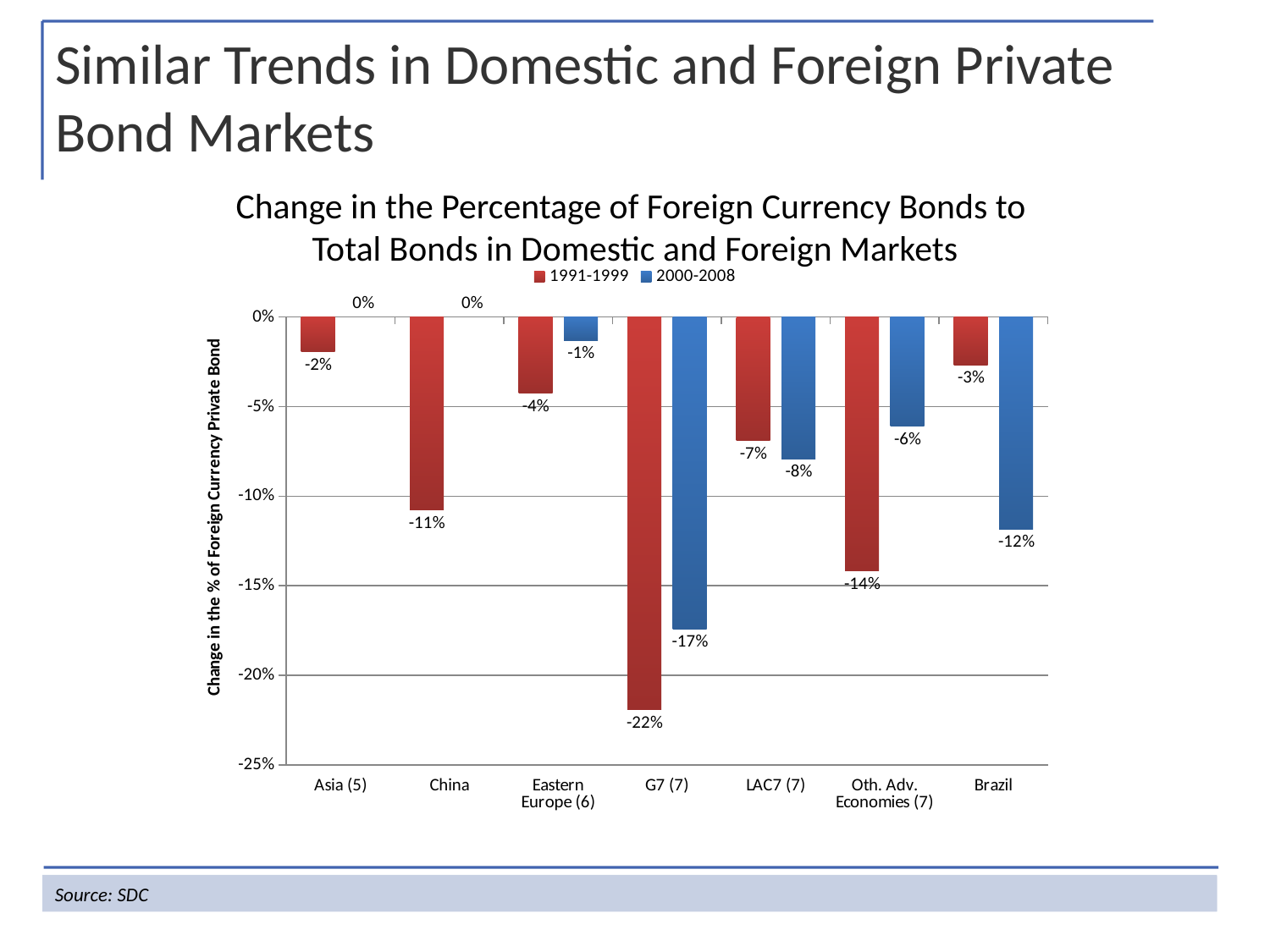
Which is larger for Brazil, the 1991-1999 value or the 2000-2008 value? 1991-1999 What is the title of the chart? Change in the Percentage of Foreign Currency Bonds to Total Bonds in Domestic and Foreign Markets What is the difference between the 1991-1999 and 2000-2008 values for Oth. Adv. Economies (7)? 8 percentage points What is the value for Oth. Adv. Economies (7) in the 1991-1999 series? -14% How many categories are shown on the x axis? 7 What is the value for Brazil in the 2000-2008 series? -12% Which category has the lowest value in the 1991-1999 series? G7 (7) How many series does the legend list? 2 What is the value for G7 (7) in the 1991-1999 series? -22% Which category has the lowest value in the 2000-2008 series? G7 (7) What kind of chart is shown on the slide? Bar chart What is the value for China in the 2000-2008 series? 0%